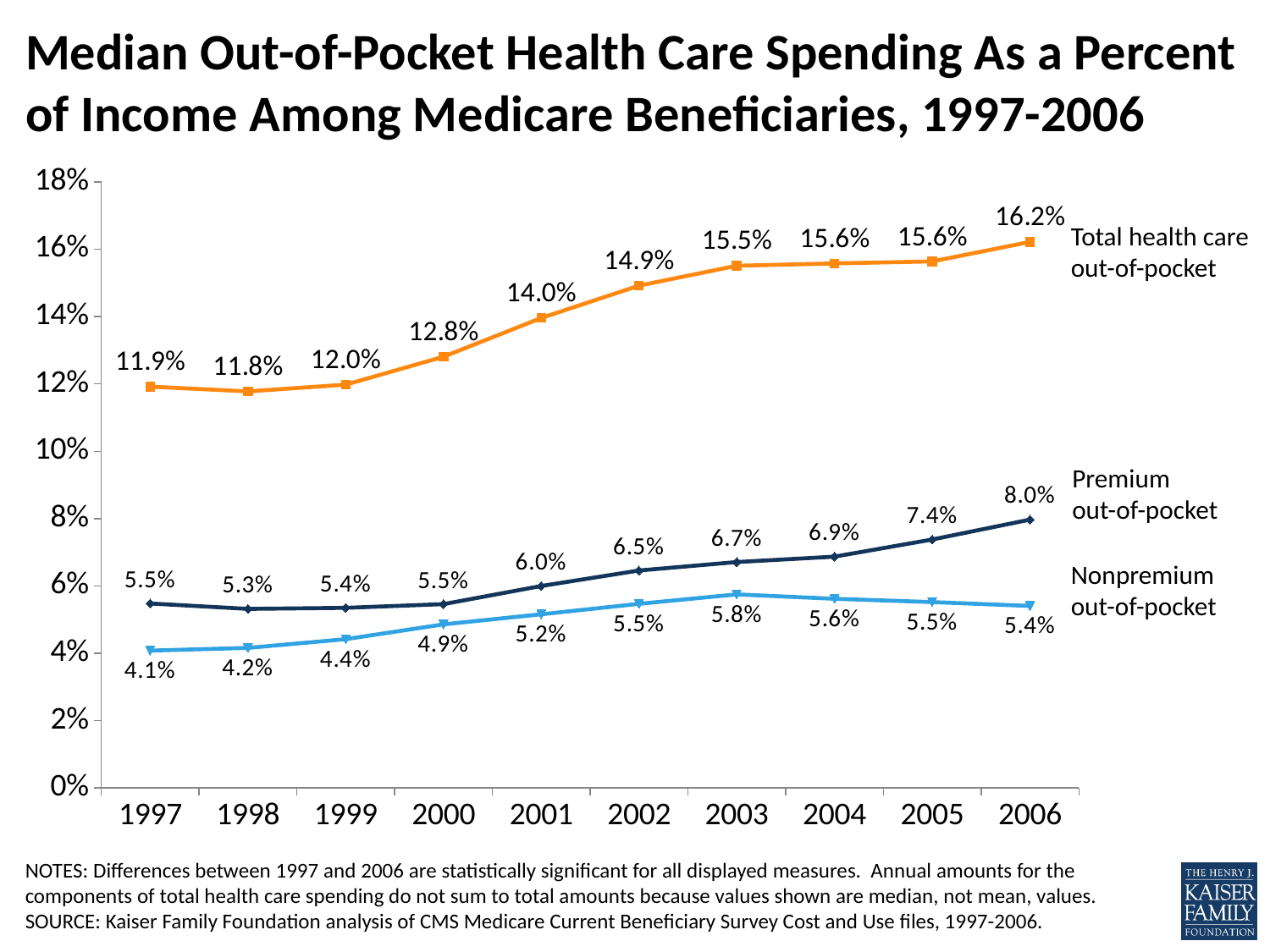
Is the total health care out-of-pocket value for 2000 greater or less than 14%? less In which year was total health care out-of-pocket spending lowest? 1998 What was the nonpremium out-of-pocket value in 1997? 4.1% How many years are shown on the x axis? 10 What is the difference between the total health care out-of-pocket values for 2006 and 1997? 4.3% Which was larger in 2006, premium out-of-pocket or nonpremium out-of-pocket? Premium out-of-pocket How many series are plotted on the chart? 3 What was the premium out-of-pocket value in 2001? 6.0% In which year was nonpremium out-of-pocket spending highest? 2003 What was the total health care out-of-pocket spending as a percent of income in 2006? 16.2% What kind of chart is shown on the slide? Line chart Does the premium out-of-pocket series generally rise or fall from 1999 to 2006? Rise